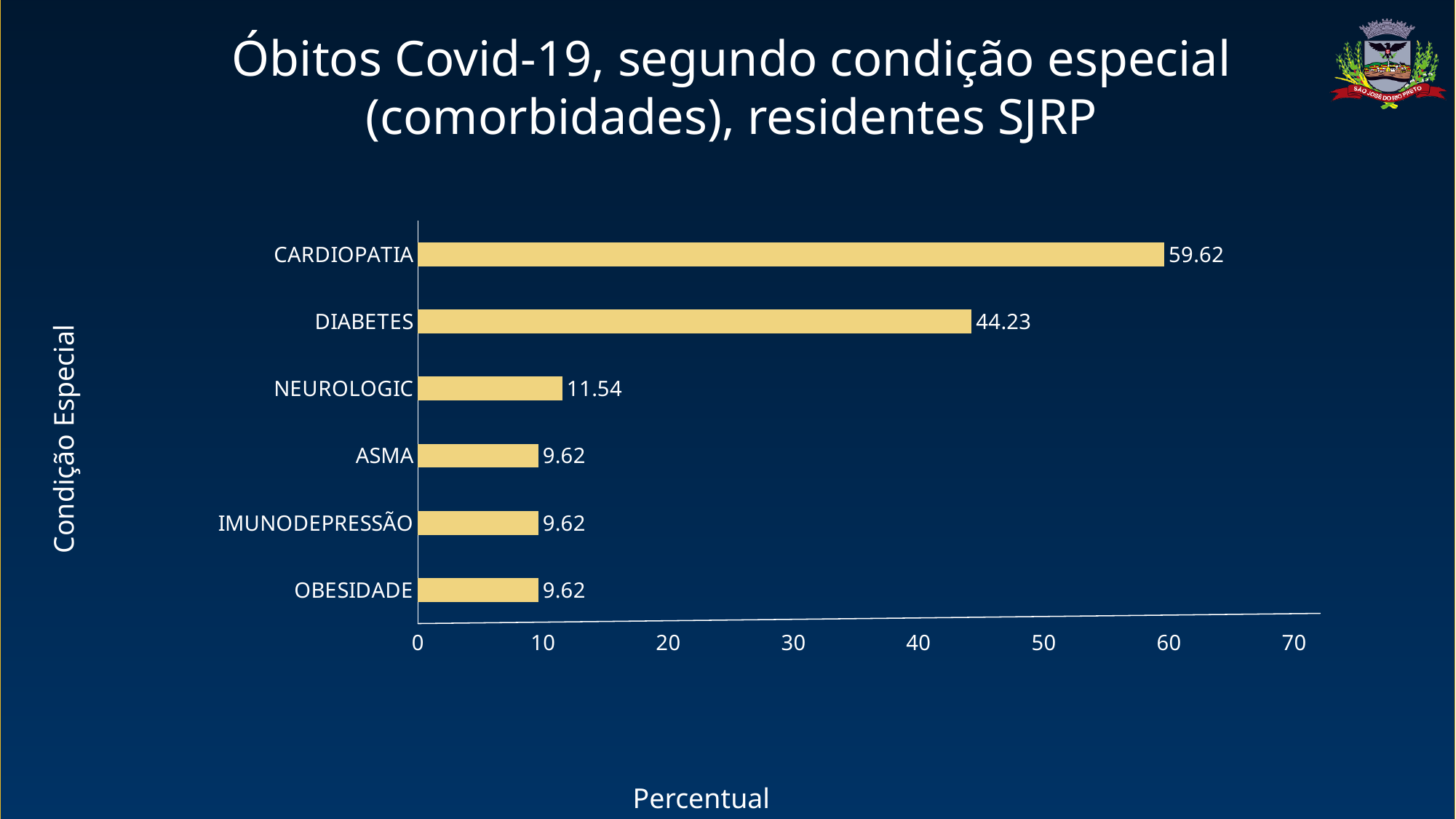
What is the value for NEUROLOGIC? 11.54 Is the value for CARDIOPATIA greater or less than 50? greater What kind of chart is shown on the slide? bar chart What is the value for CARDIOPATIA? 59.62 What is the label of the horizontal axis? Percentual Which is larger, the value for DIABETES or the value for NEUROLOGIC? DIABETES What is the difference between the values for CARDIOPATIA and DIABETES? 15.39 What is the value for DIABETES? 44.23 What is the difference between the values for NEUROLOGIC and ASMA? 1.92 What is the value for OBESIDADE? 9.62 Which category has the highest value? CARDIOPATIA How many categories are shown on the chart? 6